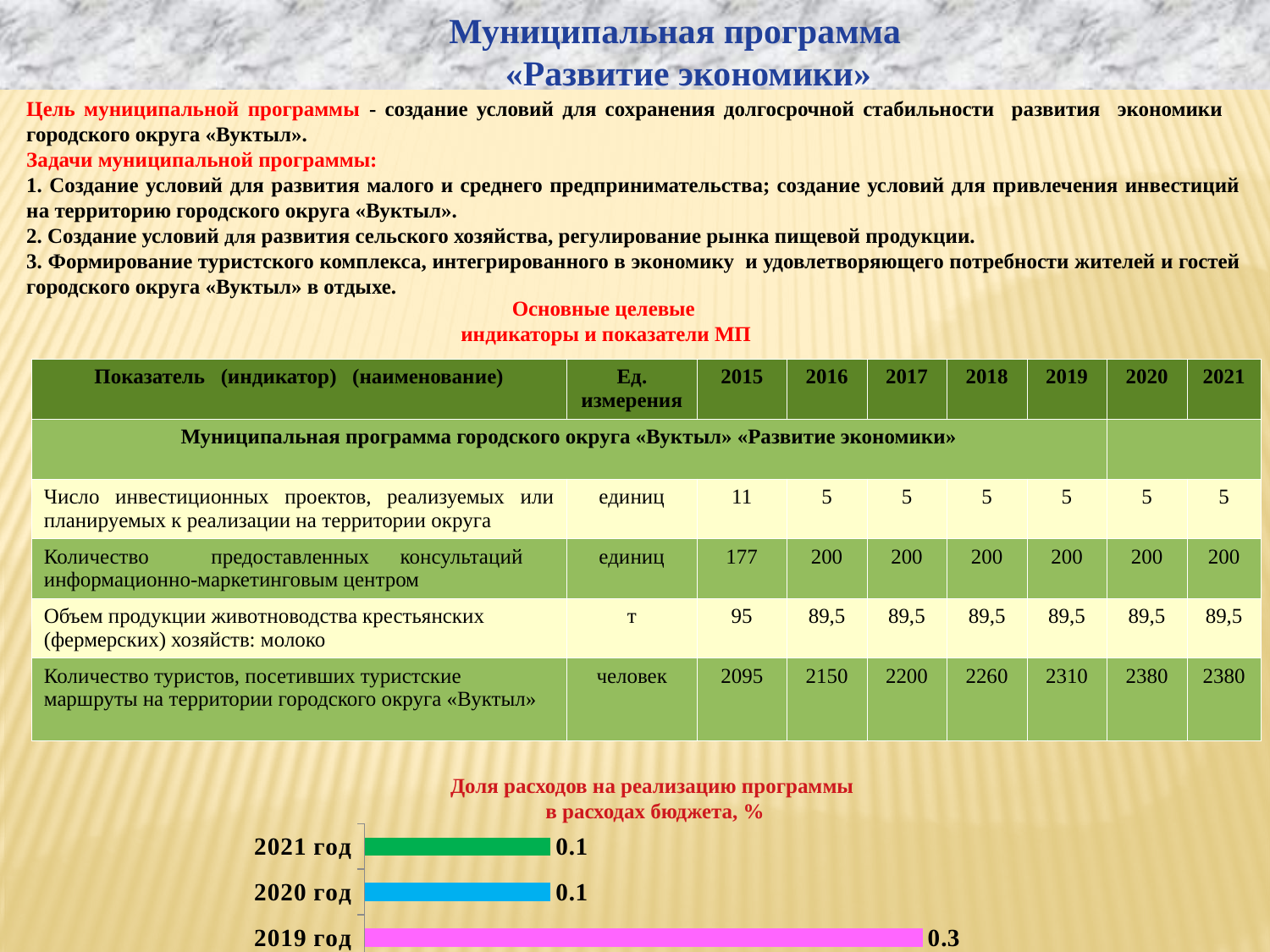
Which is larger, the value for 2019 год or the value for 2021 год? 2019 год What kind of chart is shown at the bottom of the slide? Bar chart What is the value for 2020 год in the chart? 0.1 What is the difference between the values for 2019 год and 2020 год? 0.2 Which year has the highest value in the chart? 2019 год Do the values rise or fall from 2019 год to 2021 год? Fall What colour is the bar for 2019 год? Magenta (pink) What is the value for 2019 год in the chart 'Доля расходов на реализацию программы в расходах бюджета, %'? 0.3 Are the values for 2020 год and 2021 год equal? Yes What is the title of the chart at the bottom of the slide? Доля расходов на реализацию программы в расходах бюджета, % What is the value for 2021 год in the chart? 0.1 How many years (categories) are shown in the chart? 3